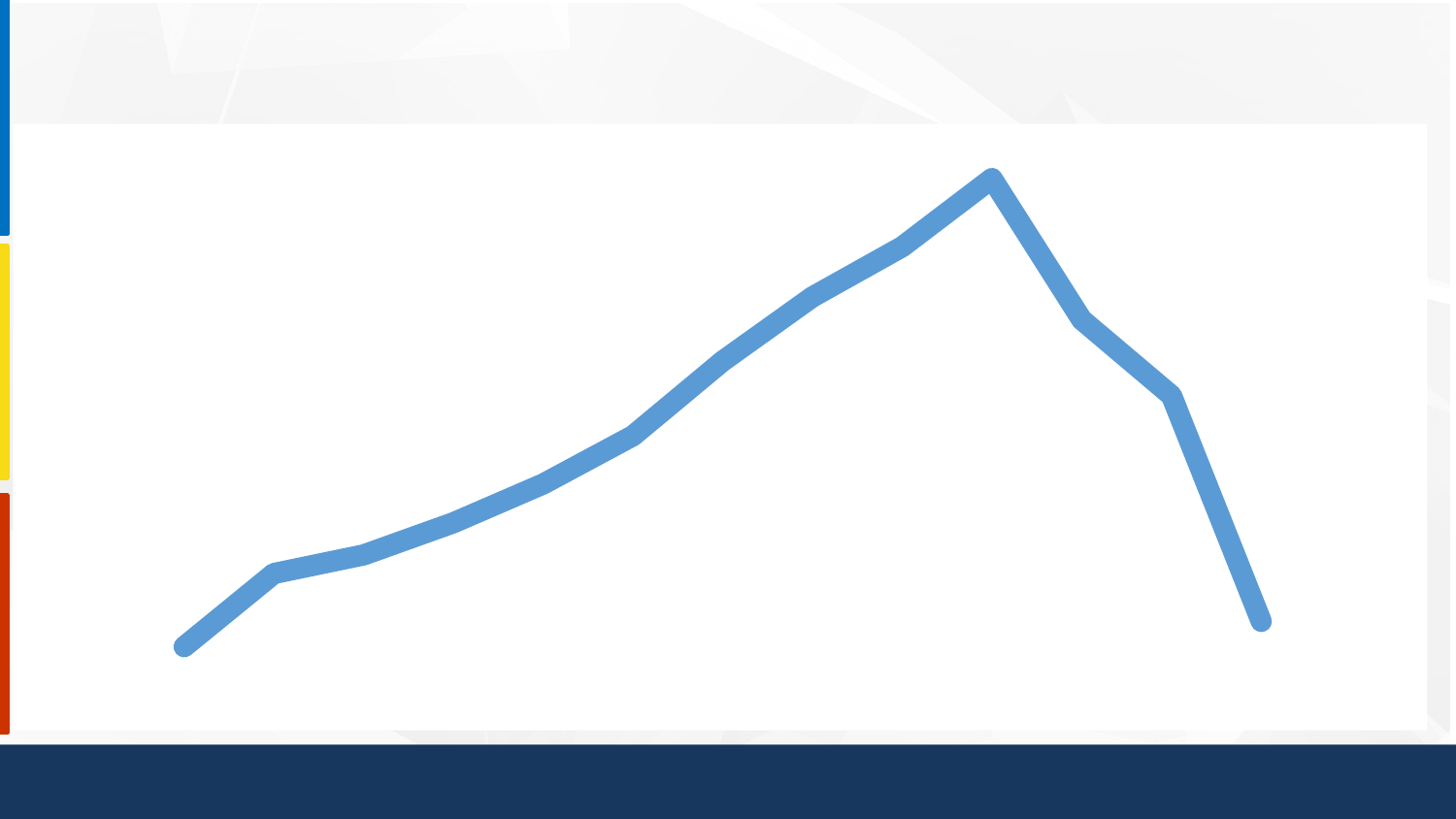
What kind of chart is shown on the slide? line chart Does the line rise or fall along the x axis overall? rises then falls What colour is the line on the chart? blue How many lines are plotted on the chart? 1 Does the line end higher or lower than where it starts? higher